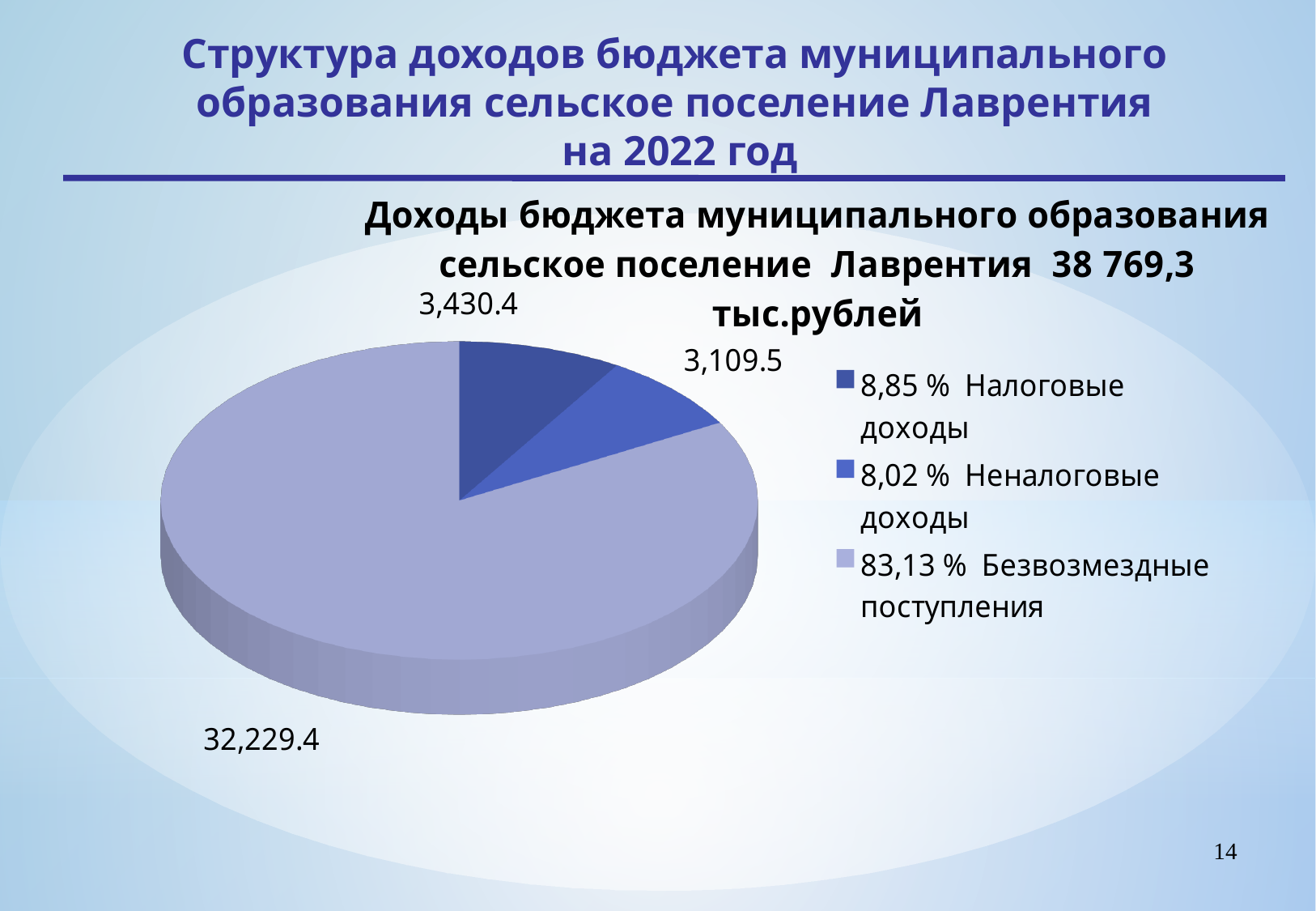
What kind of chart is shown on the slide? Pie chart Which category has the largest slice of the pie? Безвозмездные поступления What is the value for Неналоговые доходы? 3,109.5 What is the value for Безвозмездные поступления? 32,229.4 Which category has the smallest slice of the pie? Неналоговые доходы What share of the pie does Безвозмездные поступления represent, according to the legend? 83,13 % What total amount of budget revenue is stated in the chart title? 38 769,3 тыс.рублей Which is larger, the value for Налоговые доходы or the value for Неналоговые доходы? Налоговые доходы How many slices does the pie chart have? 3 What is the value for Налоговые доходы? 3,430.4 What is the difference between the values for Безвозмездные поступления and Налоговые доходы? 28,799.0 What is the difference between the values for Налоговые доходы and Неналоговые доходы? 320.9